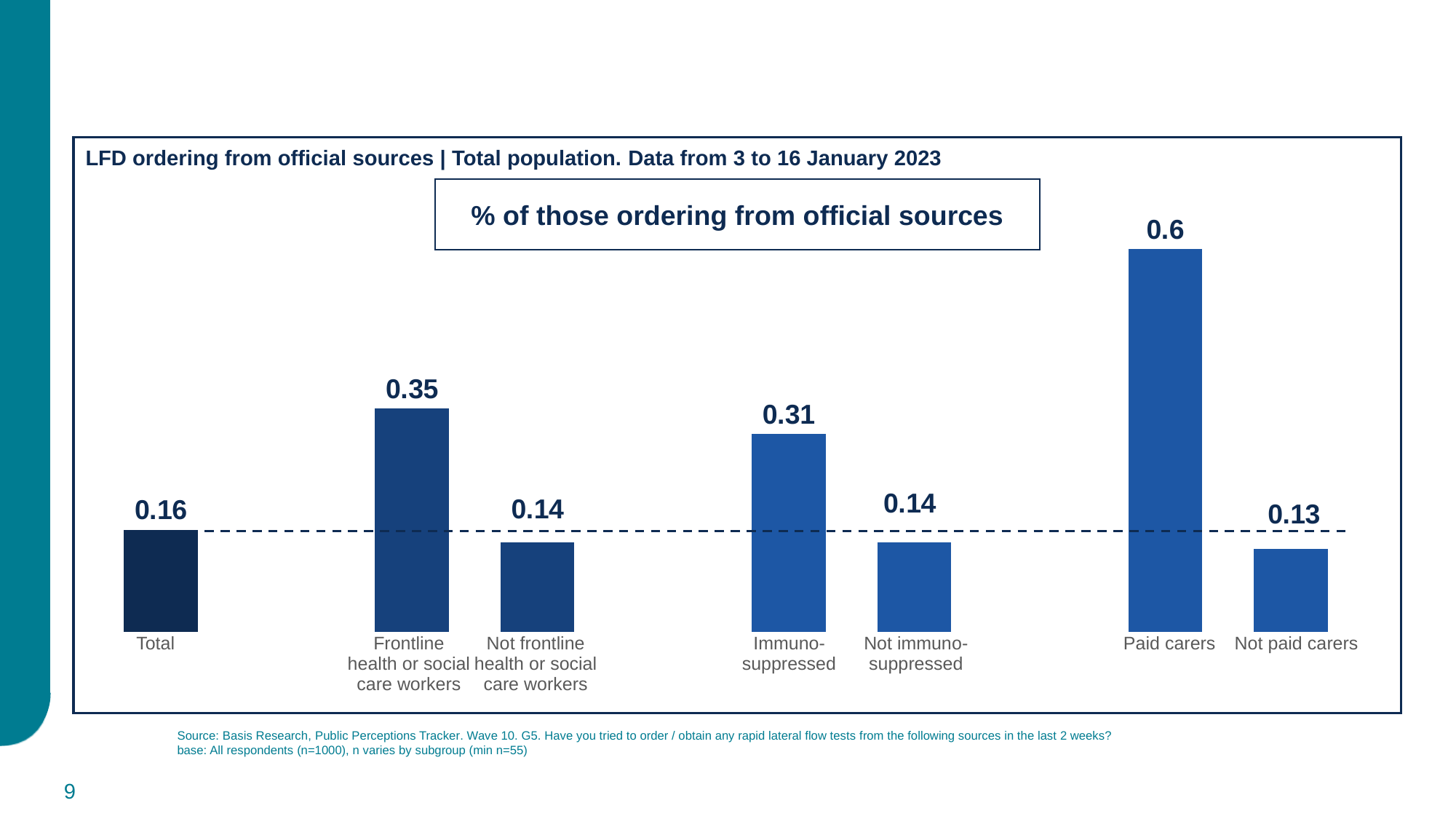
Which is larger, the value for Immuno-suppressed or the value for Not immuno-suppressed? Immuno-suppressed What is the value for Frontline health or social care workers? 0.35 Which category has the lowest value? Not paid carers What is the difference between the values for Paid carers and Not paid carers? 0.47 What is the value for Immuno-suppressed? 0.31 What kind of chart is shown on the slide? Bar chart What is the value for Paid carers? 0.6 How many bars are shown in the chart? 7 What is the title shown in the box above the bars? % of those ordering from official sources Which category has the highest value? Paid carers What is the value for Total? 0.16 What is the difference between the values for Frontline health or social care workers and Not frontline health or social care workers? 0.21